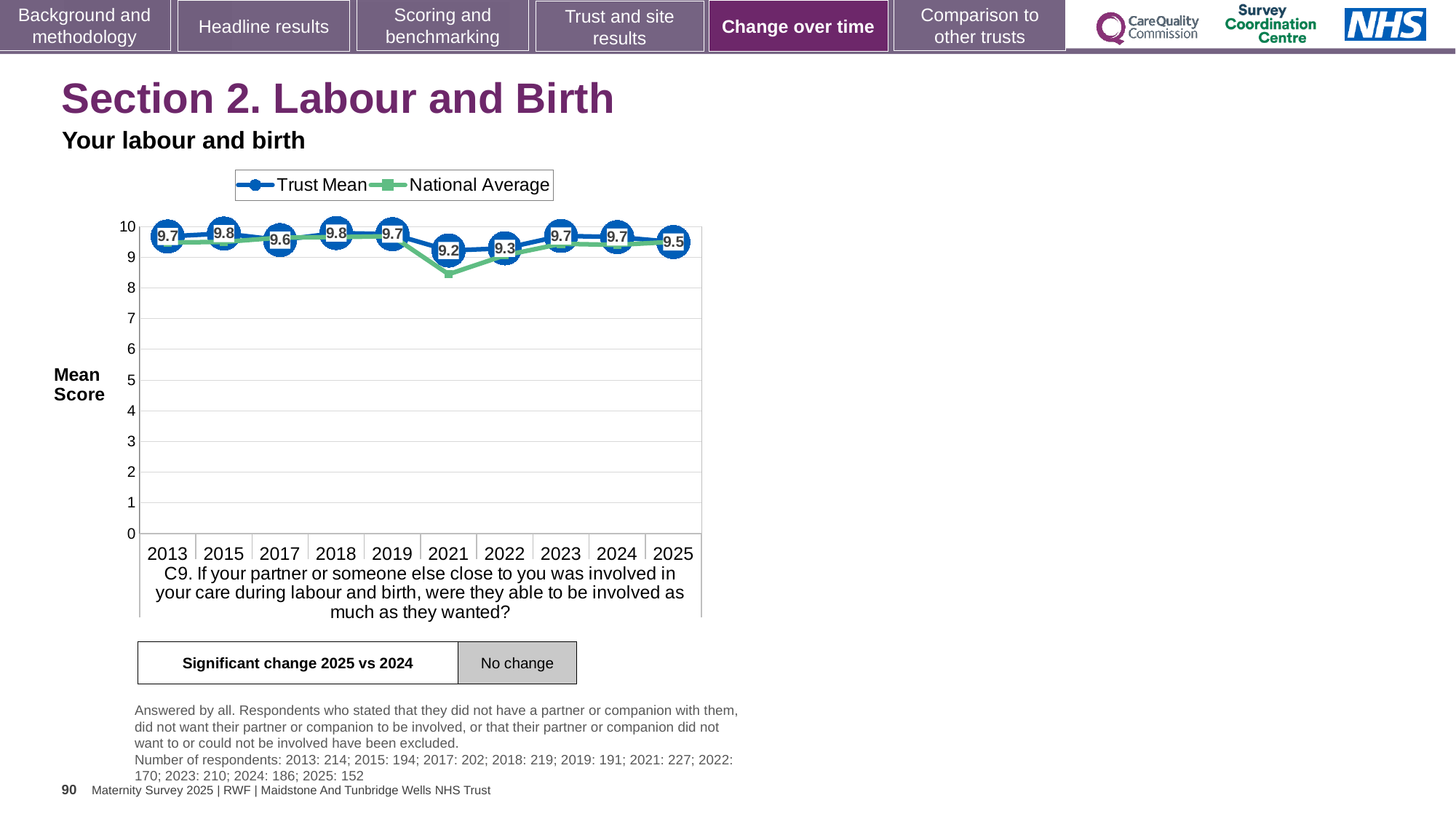
Which year has the higher Trust Mean score, 2021 or 2023? 2023 How many series does the legend list? 2 What is the label on the y axis of the chart? Mean Score Is the National Average value for 2021 greater or less than 9? less Does the Trust Mean score rise or fall from 2021 to 2023? rise What is the difference between the Trust Mean scores for 2018 and 2021? 0.6 What is the Trust Mean score for 2013? 9.7 In which year is the Trust Mean score lowest? 2021 What is the Trust Mean score for 2025? 9.5 What kind of chart is shown on the slide? line chart How many years are plotted on the x axis? 10 What is the Trust Mean score for 2021? 9.2